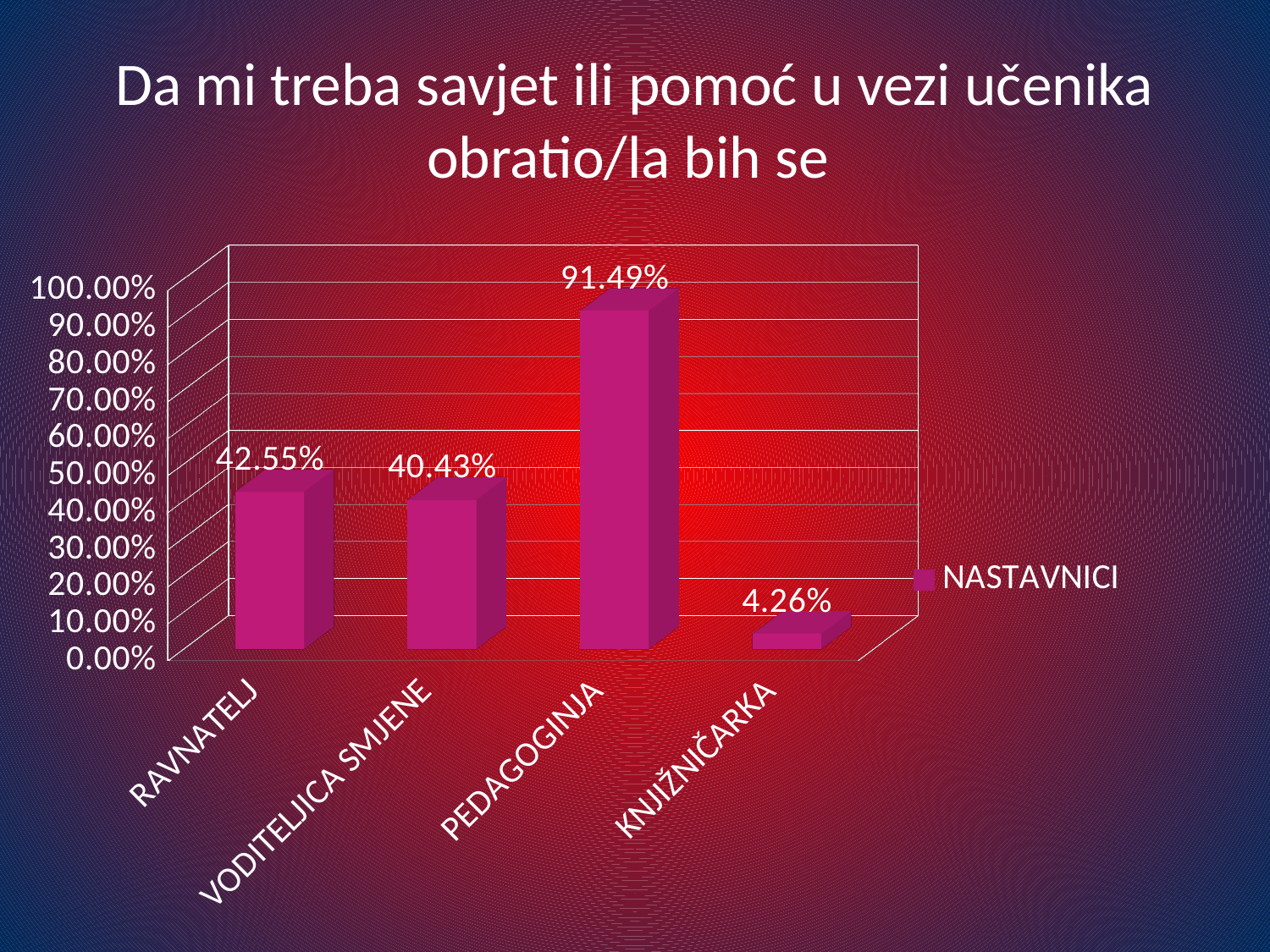
How many categories are shown on the x axis? 4 What is the value for RAVNATELJ? 42.55% What is the value for VODITELJICA SMJENE? 40.43% What is the difference between the values for RAVNATELJ and VODITELJICA SMJENE? 2.12% What kind of chart is shown on the slide? bar chart What is the value for PEDAGOGINJA? 91.49% Which category has the highest value? PEDAGOGINJA Which category has the lowest value? KNJIŽNIČARKA Which is larger, the value for RAVNATELJ or the value for KNJIŽNIČARKA? RAVNATELJ How many series does the legend list? 1 What is the difference between the values for PEDAGOGINJA and RAVNATELJ? 48.94% What is the value for KNJIŽNIČARKA? 4.26%